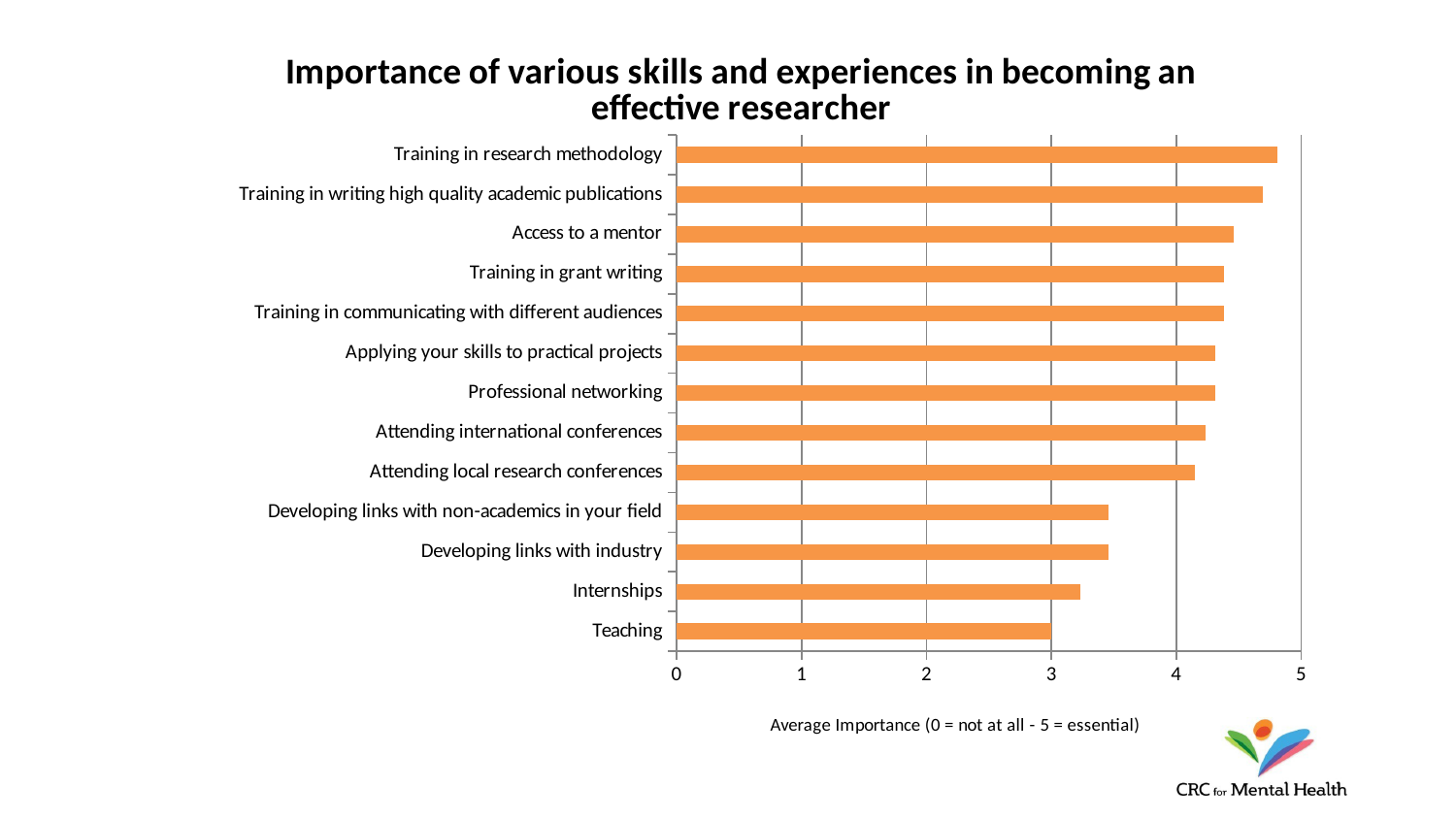
What kind of chart is shown on the slide? bar chart Is the value for Teaching greater or less than 4? less Which skill or experience has the highest average importance? Training in research methodology Which skill or experience has the lowest average importance? Teaching Which has a higher average importance, Internships or Teaching? Internships What is the label on the horizontal axis of the chart? Average Importance (0 = not at all - 5 = essential) Is the value for Developing links with industry greater or less than 4? less Is the value for Internships greater or less than 3? greater How many skills or experiences are listed on the chart? 13 Which has a higher average importance, Access to a mentor or Developing links with industry? Access to a mentor What is the title of the chart? Importance of various skills and experiences in becoming an effective researcher